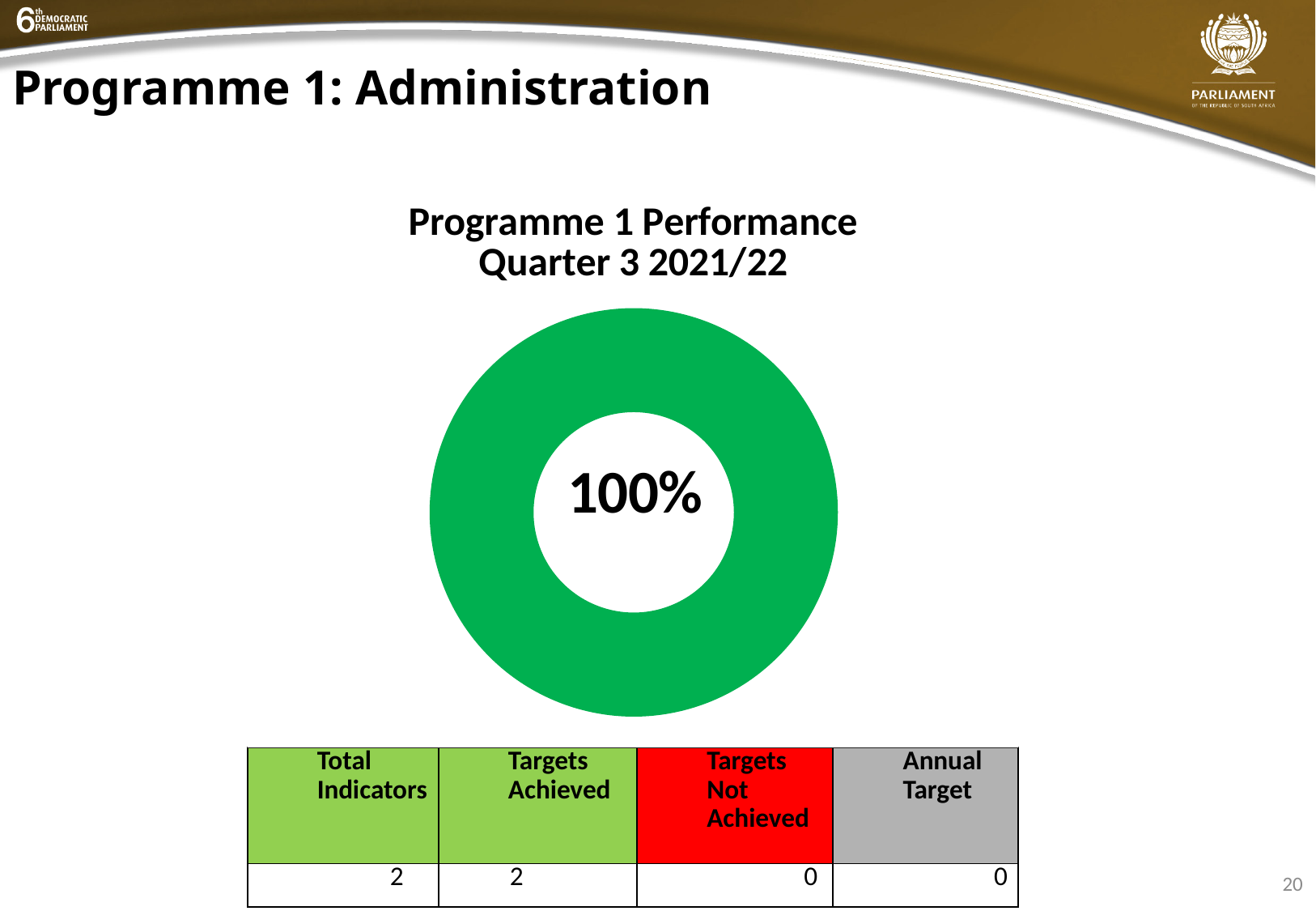
What percentage is displayed in the centre of the doughnut chart? 100% How many visible slices does the doughnut chart have? 1 Which quarter does the chart report performance for? Quarter 3 2021/22 What colour is the ring of the doughnut chart? green Is the value shown in the doughnut chart greater or less than 50%? greater What is the title of the chart? Programme 1 Performance Quarter 3 2021/22 What share of the doughnut chart does the green slice occupy? 100% What kind of chart is shown on the slide? doughnut chart